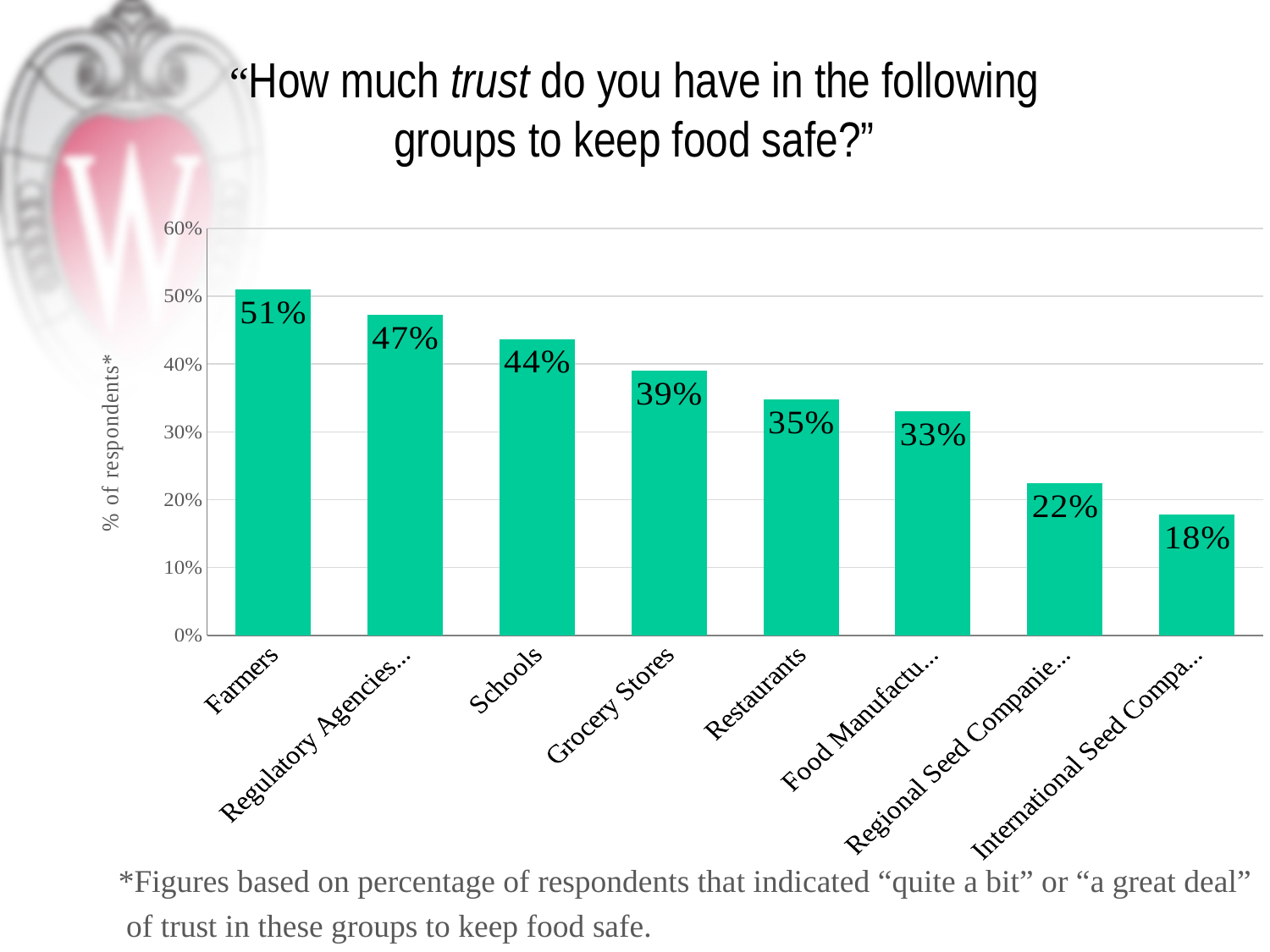
Which has a higher value, Grocery Stores or Restaurants? Grocery Stores Which group has the lowest level of trust in the chart? International Seed Companies What kind of chart is shown on the slide? Bar chart Do the values rise or fall moving from left to right across the chart? Fall What is the value shown for Schools? 44% What percentage of respondents trust Farmers to keep food safe? 51% Which group has the highest level of trust in the chart? Farmers What is the value shown for Restaurants? 35% What is the value shown for Grocery Stores? 39% What is the difference between the values for Regional Seed Companies and International Seed Companies? 4% How many groups are shown in the chart? 8 What is the difference between the values for Farmers and Regulatory Agencies? 4%